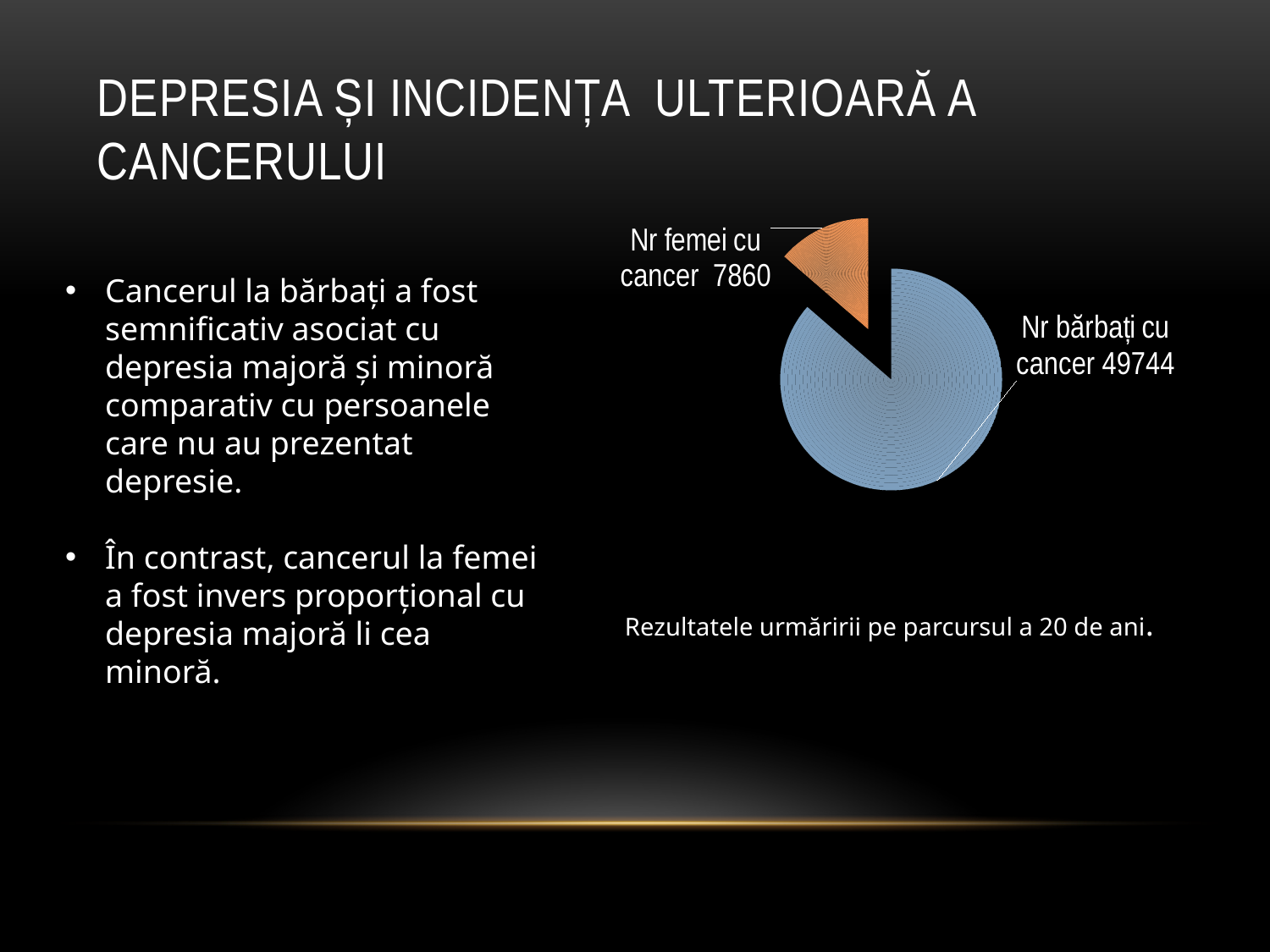
What is the value shown for "Nr femei cu cancer"? 7860 Which is larger, the number of women with cancer or the number of men with cancer? Nr bărbați cu cancer Which slice of the pie chart is the smallest? Nr femei cu cancer What kind of chart is shown on the slide? pie chart What colour is the slice for "Nr femei cu cancer"? orange What is the difference between the number of men with cancer and the number of women with cancer? 41884 What is the value shown for "Nr bărbați cu cancer"? 49744 What colour is the slice for "Nr bărbați cu cancer"? blue What is the total of the two values shown in the pie chart? 57604 Which slice of the pie chart is the largest? Nr bărbați cu cancer How many slices does the pie chart have? 2